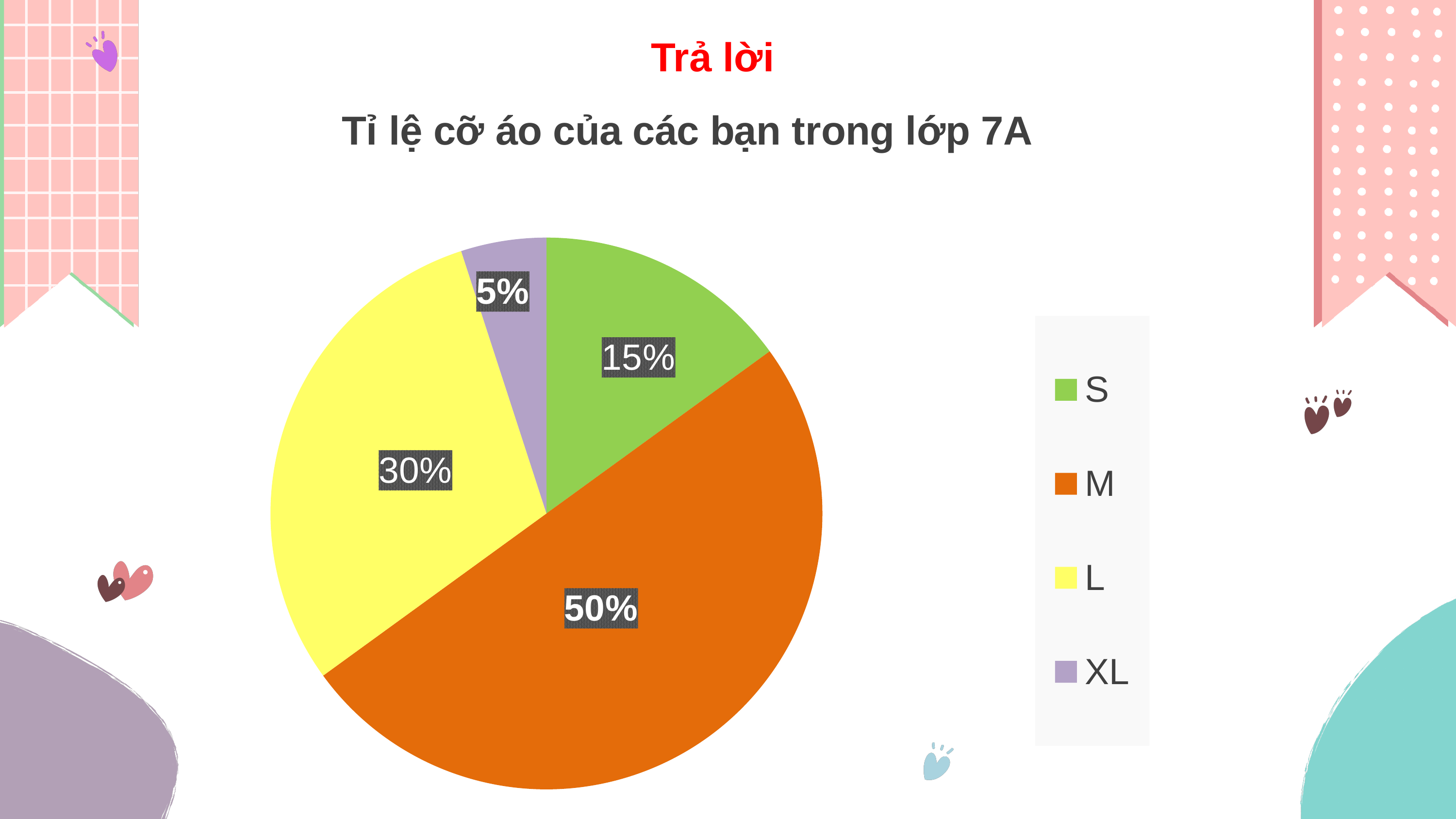
What is the share for size L? 30% Which has a larger share, S or L? L Which size has the smallest share? XL Which size has the largest share? M How many slices does the pie chart have? 4 What is the difference between the shares for M and L? 20% What is the share for size XL? 5% What is the share for size S? 15% What is the title of the chart? Tỉ lệ cỡ áo của các bạn trong lớp 7A What colour is the slice for size L? yellow What is the share for size M? 50% What kind of chart is shown on the slide? pie chart